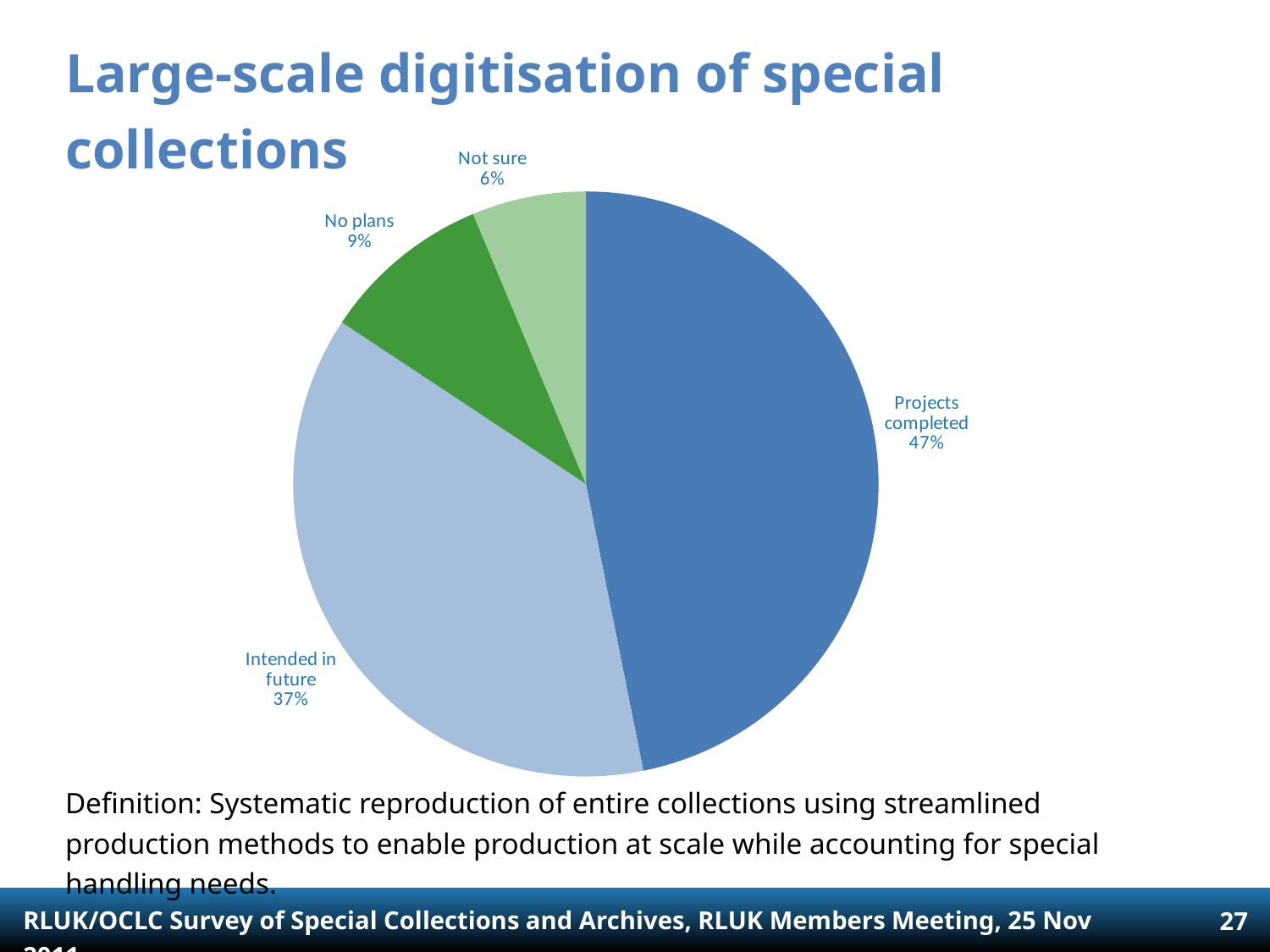
What share of the pie is labelled 'Intended in future'? 37% What share of the pie is labelled 'Not sure'? 6% What share of the pie is labelled 'Projects completed'? 47% What is the combined share of 'No plans' and 'Not sure'? 15% What is the difference in percentage points between 'Projects completed' and 'Intended in future'? 10 Which slice of the pie is the largest? Projects completed Which is larger, the 'No plans' slice or the 'Not sure' slice? No plans Which slice of the pie is the smallest? Not sure How many slices does the pie chart have? 4 What is the title of the slide containing the pie chart? Large-scale digitisation of special collections What kind of chart is shown on the slide? pie chart